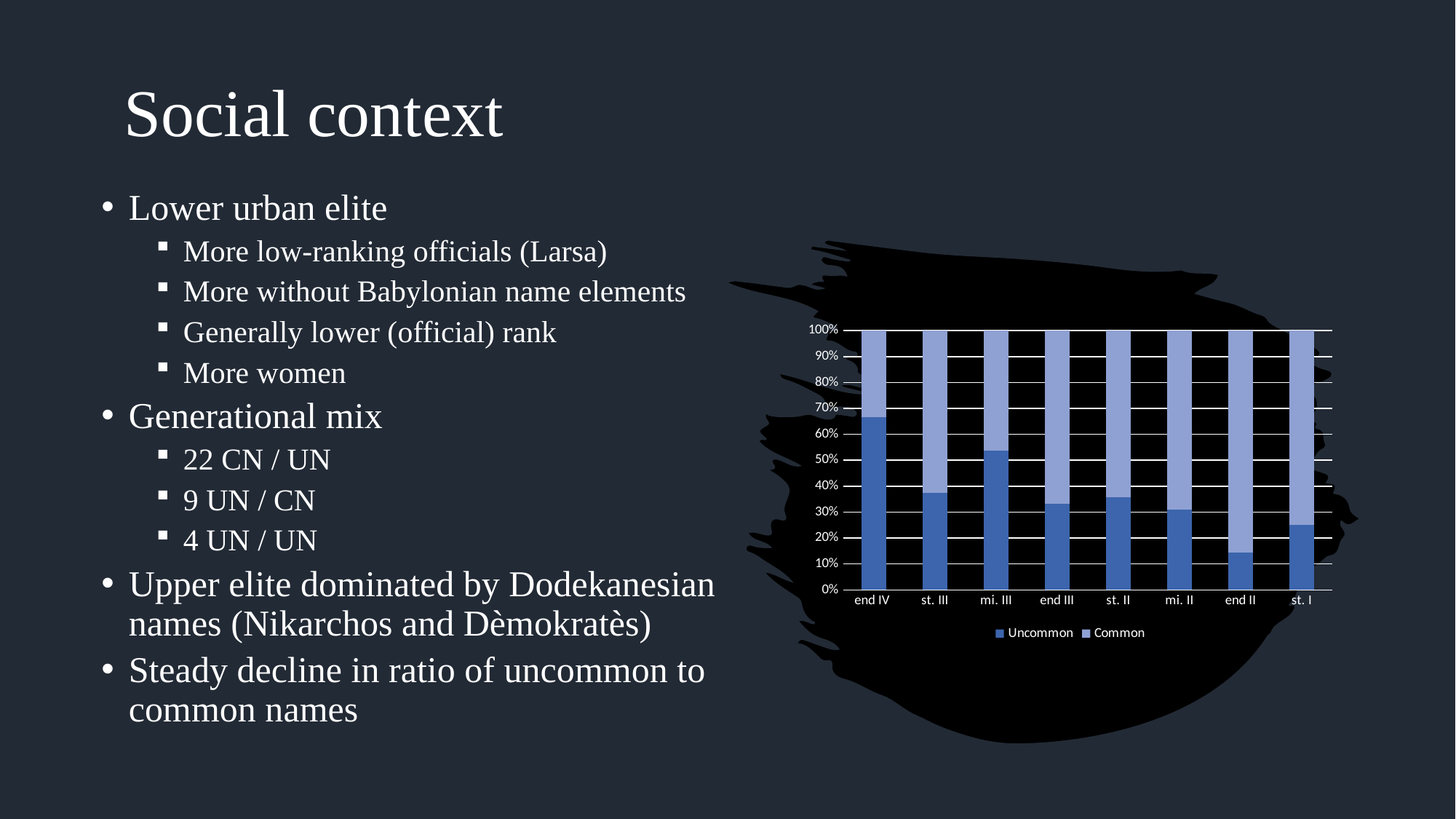
Is the Uncommon share for st. I greater or less than 30%? less What kind of chart is shown on the slide? stacked bar chart Does the Uncommon share generally rise or fall from end IV to st. I? fall How many categories are shown on the x axis of the chart? 8 What are the two series named in the chart's legend? Uncommon and Common Is the Uncommon share for end II greater or less than 20%? less Which category has the highest Uncommon share? end IV Is the Uncommon share for mi. III greater or less than 50%? greater Which category has the lowest Uncommon share? end II How many series does the chart's legend list? 2 Which has a larger Uncommon share, st. III or end II? st. III